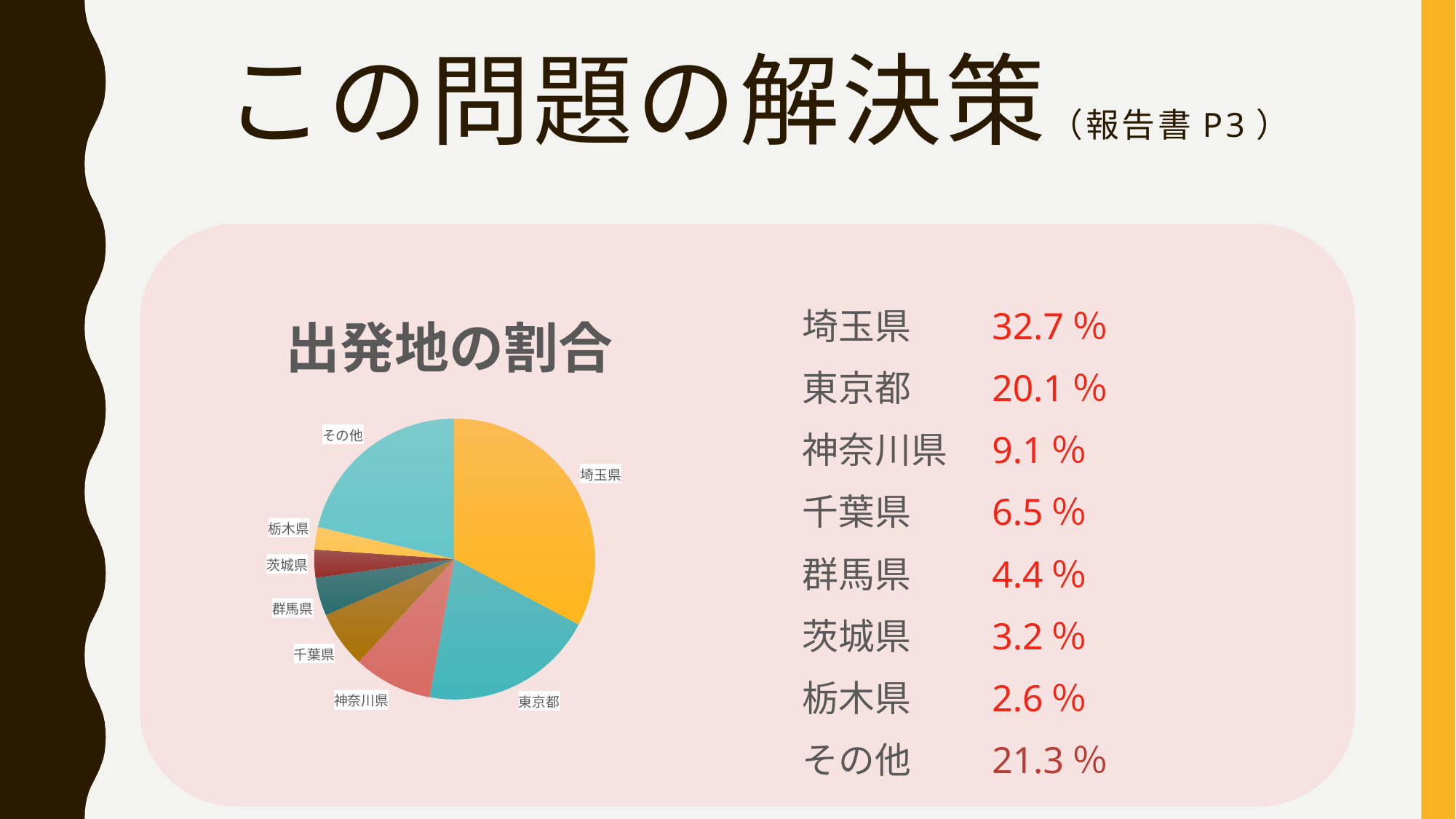
What is the title of the chart? 出発地の割合 Which category has the smallest slice of the pie? 栃木県 Which is larger, the share for 千葉県 or the share for 群馬県? 千葉県 What is the difference between the shares of 茨城県 and 栃木県? 0.6 % What kind of chart is shown on the slide? pie chart What is the share for その他? 21.3 % What is the share for 東京都? 20.1 % How many slices does the pie chart have? 8 Which category has the largest slice of the pie? 埼玉県 What is the share for 埼玉県? 32.7 % What is the difference between the shares of 埼玉県 and 東京都? 12.6 % What is the share for 神奈川県? 9.1 %